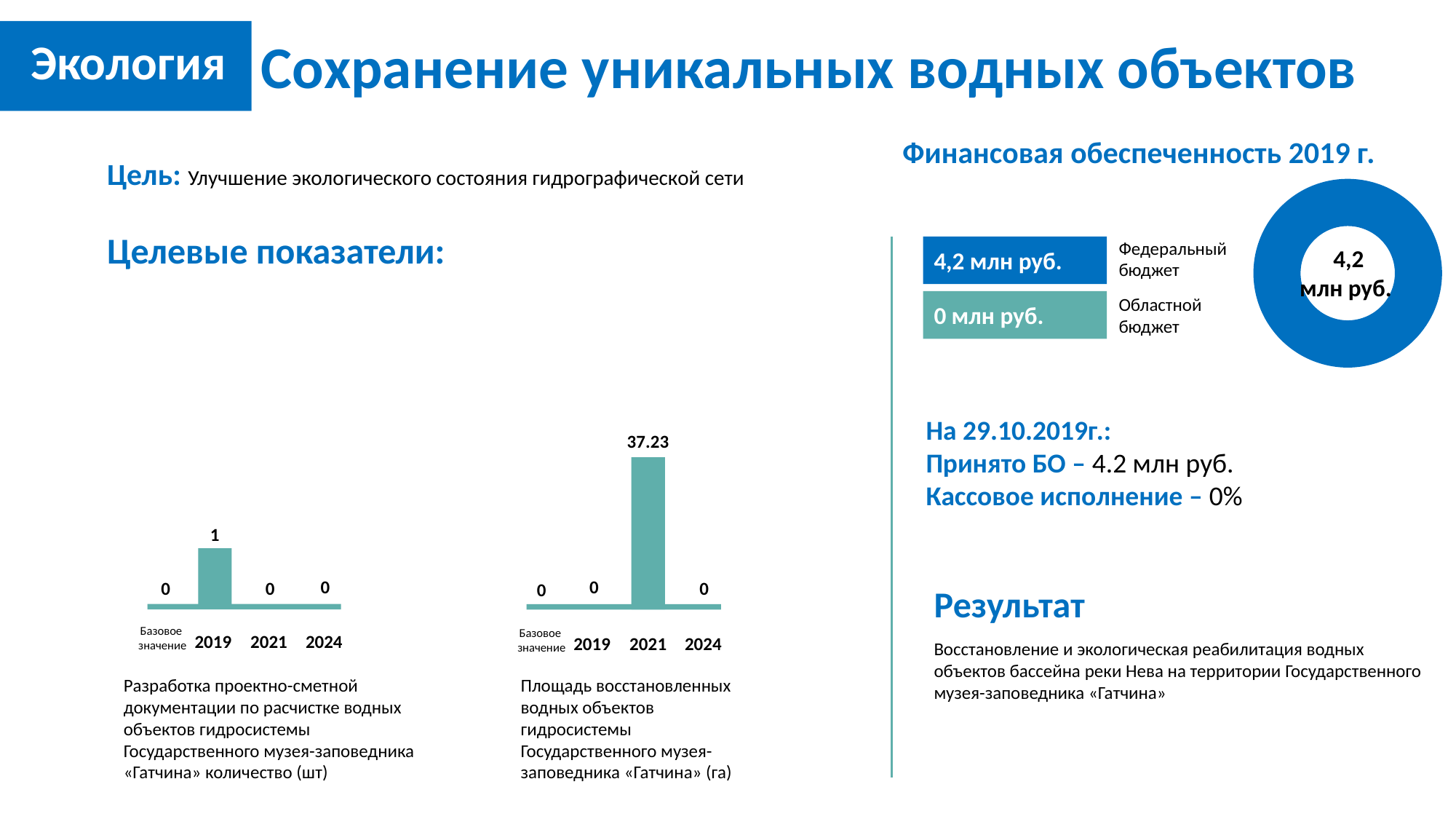
In the middle bar chart (Площадь восстановленных водных объектов), what is the value for Базовое значение? 0 In the donut chart under Финансовая обеспеченность 2019 г., what is the value for Федеральный бюджет? 4,2 млн руб. What kind of chart is used for the target indicators (Целевые показатели) on the left side of the slide? Bar chart In the middle bar chart (Площадь восстановленных водных объектов), what is the difference between the values for 2021 and 2024? 37.23 In the middle bar chart (Площадь восстановленных водных объектов), what is the value for 2021? 37.23 In the left bar chart (Разработка проектно-сметной документации), which category has the highest value? 2019 In the middle bar chart (Площадь восстановленных водных объектов), which is larger: the value for 2019 or the value for 2021? 2021 In the left bar chart (Разработка проектно-сметной документации), what is the value for 2024? 0 In the donut chart under Финансовая обеспеченность 2019 г., what is the value for Областной бюджет? 0 млн руб. How many categories are shown on the x axis of the left bar chart (Разработка проектно-сметной документации)? 4 In the middle bar chart (Площадь восстановленных водных объектов), which category has the highest value? 2021 In the left bar chart (Разработка проектно-сметной документации), what is the value for 2019? 1